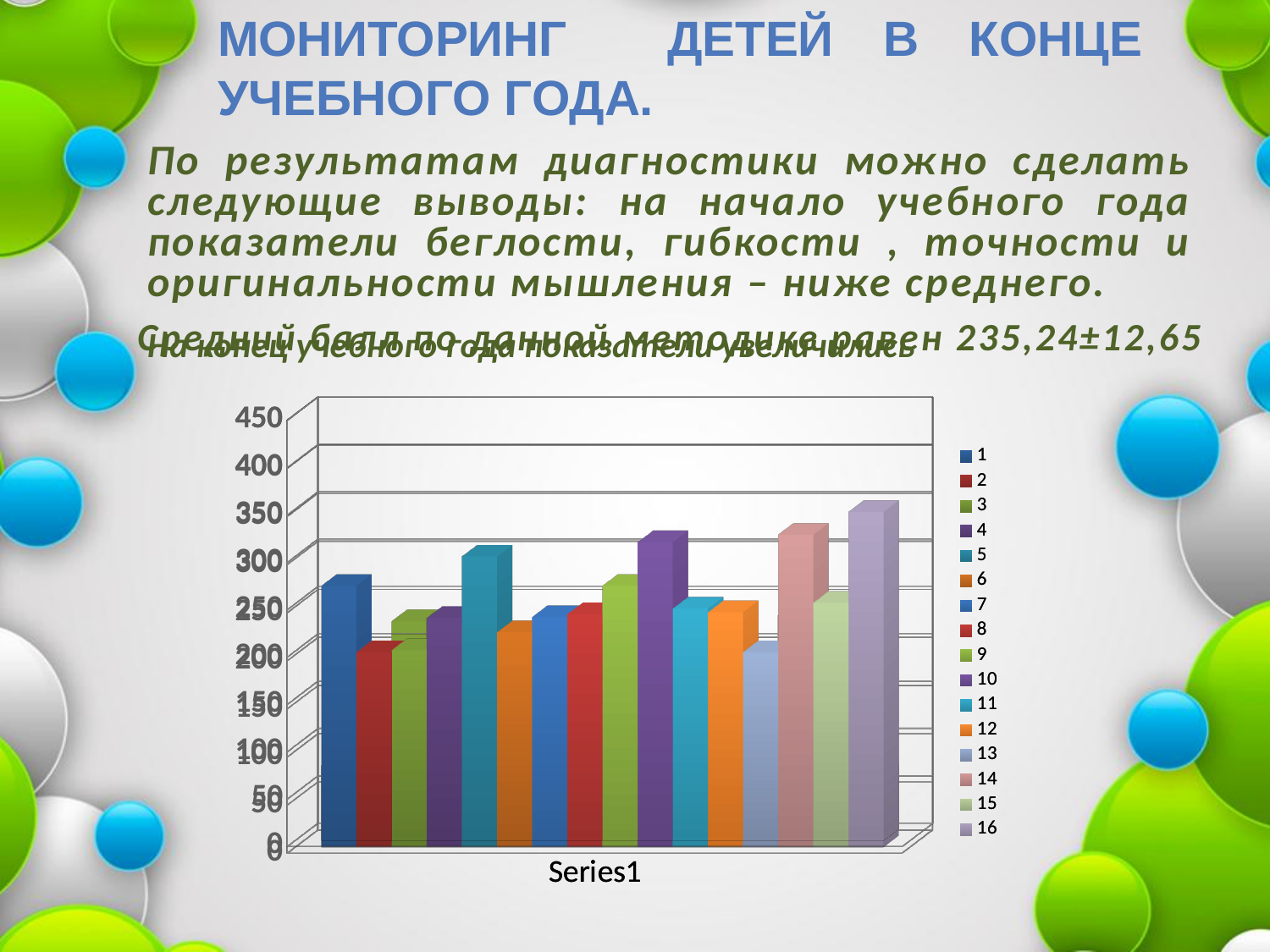
How many categories are shown on the x axis? 1 Is the value for series 13 greater or less than 250? less What is the highest value shown on the vertical axis? 450 Is the value for series 16 greater or less than 300? greater What kind of chart is shown on the slide? bar chart Which is larger, the value for series 10 or the value for series 13? series 10 Which series has the highest bar? 16 Is the value for series 2 greater or less than 250? less Which is larger, the value for series 5 or the value for series 6? series 5 What is the category label shown on the x axis? Series1 How many series does the legend list? 16